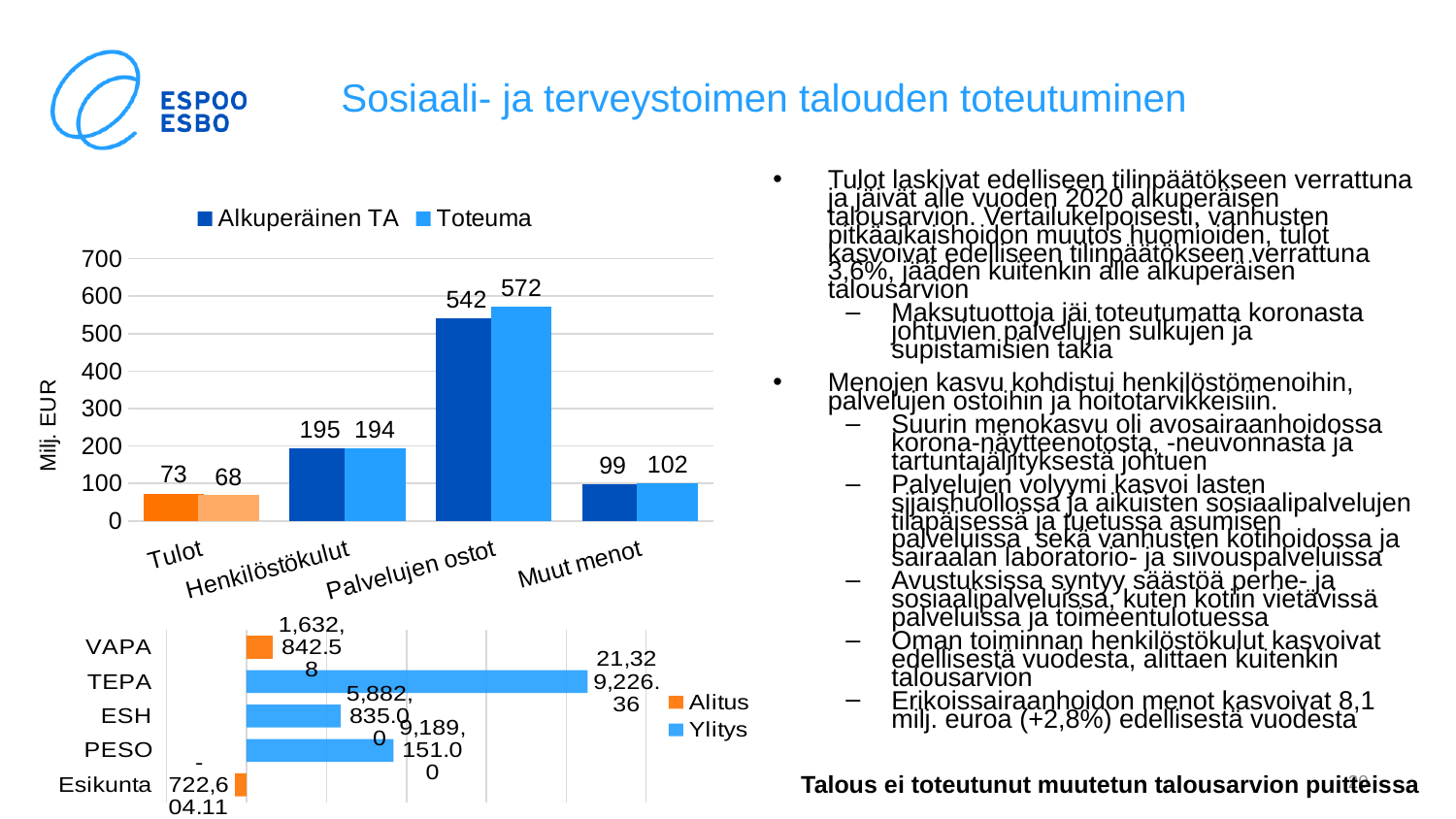
In the top chart, which category has the lowest Alkuperäinen TA value? Tulot In the top chart, which category has the highest Toteuma value? Palvelujen ostot What kind of chart is the top chart? Bar chart In the top chart, how many categories are shown on the x axis? 4 In the top chart, what is the difference between the Toteuma and Alkuperäinen TA values for Palvelujen ostot? 30 In the top chart, which is larger for Henkilöstökulut: Alkuperäinen TA or Toteuma? Alkuperäinen TA In the bottom chart, which category has the longest Ylitys bar? TEPA In the bottom chart, how many categories are listed on the vertical axis? 5 In the top chart, how many series does the legend list? 2 In the top chart, what is the Alkuperäinen TA value for Tulot? 73 In the top chart, what is the Toteuma value for Palvelujen ostot? 572 In the top chart, what is the Toteuma value for Muut menot? 102